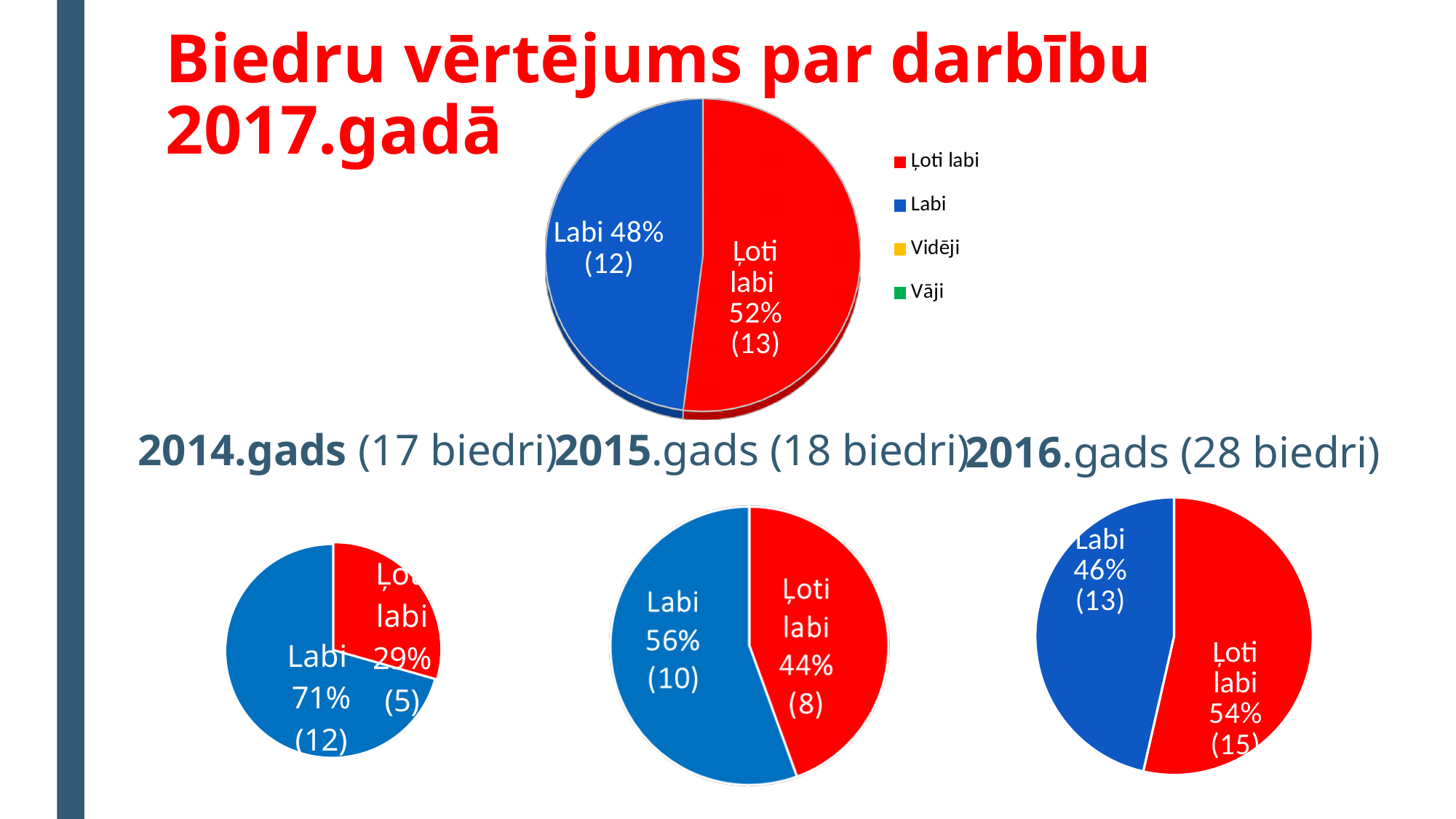
In the top pie chart (2017), how many members are shown in parentheses for Labi? 12 How many pie charts are shown on the slide in total? 4 According to the legend, what colour represents Labi? Blue What kind of chart is used for the 2017 data at the top of the slide? Pie chart How many entries does the legend next to the top pie chart list? 4 In the 2014.gads pie chart, which slice is larger, Labi or Ļoti labi? Labi In the 2014.gads pie chart, what percentage is labelled for Labi? 71% In the 2016.gads pie chart, what percentage is labelled for Ļoti labi? 54% In the top pie chart (2017), what percentage is labelled for Ļoti labi? 52% In the 2015.gads pie chart, what is the difference in percentage points between Labi and Ļoti labi? 12 In the 2015.gads pie chart, how many members are shown in parentheses for Ļoti labi? 8 In the 2016.gads pie chart, which slice is the largest? Ļoti labi